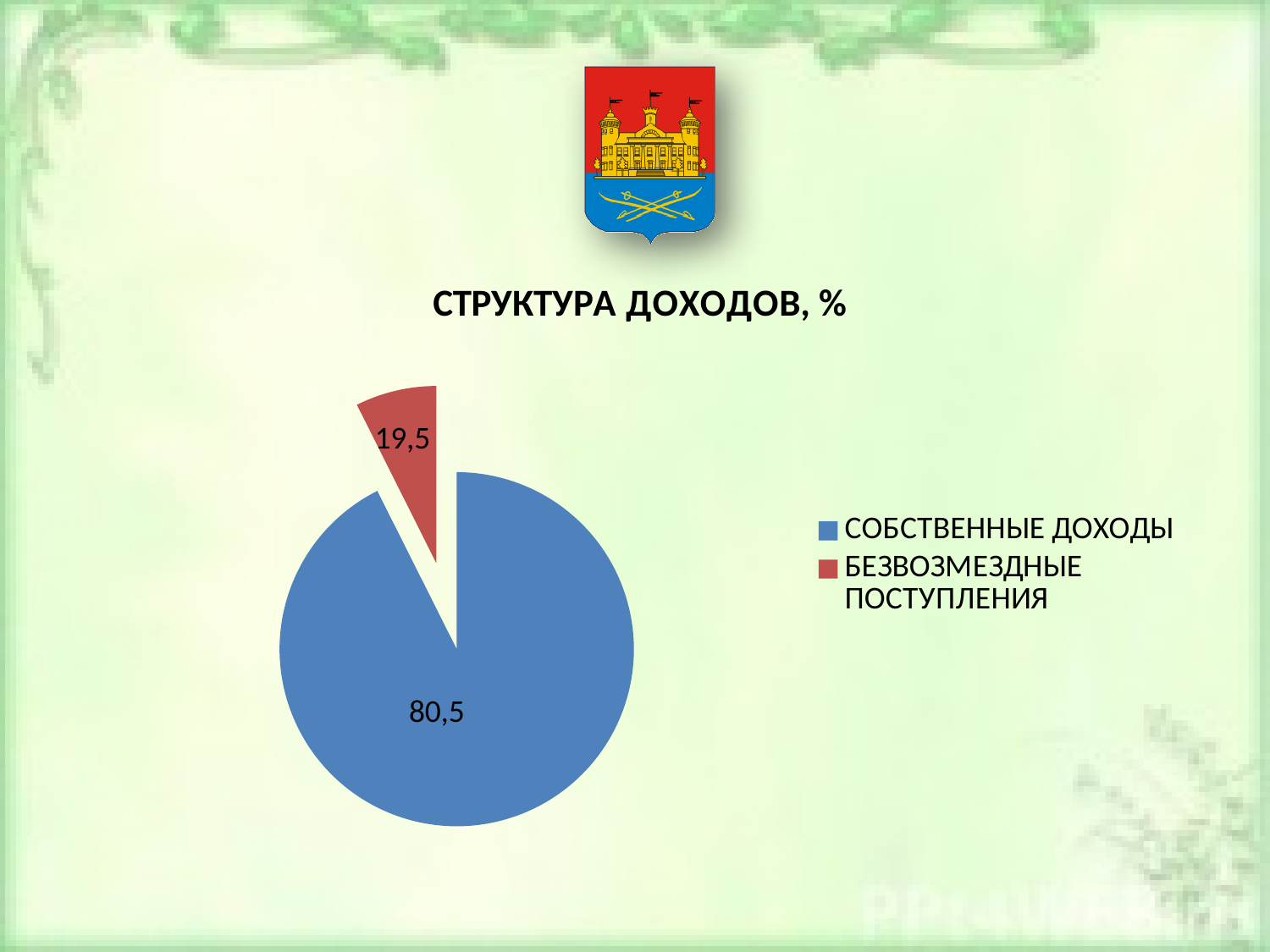
How many entries does the legend list? 2 What share of the pie does БЕЗВОЗМЕЗДНЫЕ ПОСТУПЛЕНИЯ represent? 19,5% What kind of chart is shown on the slide? Pie chart How many slices does the pie chart have? 2 Which is larger, СОБСТВЕННЫЕ ДОХОДЫ or БЕЗВОЗМЕЗДНЫЕ ПОСТУПЛЕНИЯ? СОБСТВЕННЫЕ ДОХОДЫ Which category has the largest slice in the pie chart? СОБСТВЕННЫЕ ДОХОДЫ What is the title of the chart? СТРУКТУРА ДОХОДОВ, % What is the value for СОБСТВЕННЫЕ ДОХОДЫ in the pie chart? 80,5 What colour is the slice for БЕЗВОЗМЕЗДНЫЕ ПОСТУПЛЕНИЯ? Red What is the value for БЕЗВОЗМЕЗДНЫЕ ПОСТУПЛЕНИЯ in the pie chart? 19,5 Which category has the smallest slice in the pie chart? БЕЗВОЗМЕЗДНЫЕ ПОСТУПЛЕНИЯ What is the difference between the values for СОБСТВЕННЫЕ ДОХОДЫ and БЕЗВОЗМЕЗДНЫЕ ПОСТУПЛЕНИЯ? 61